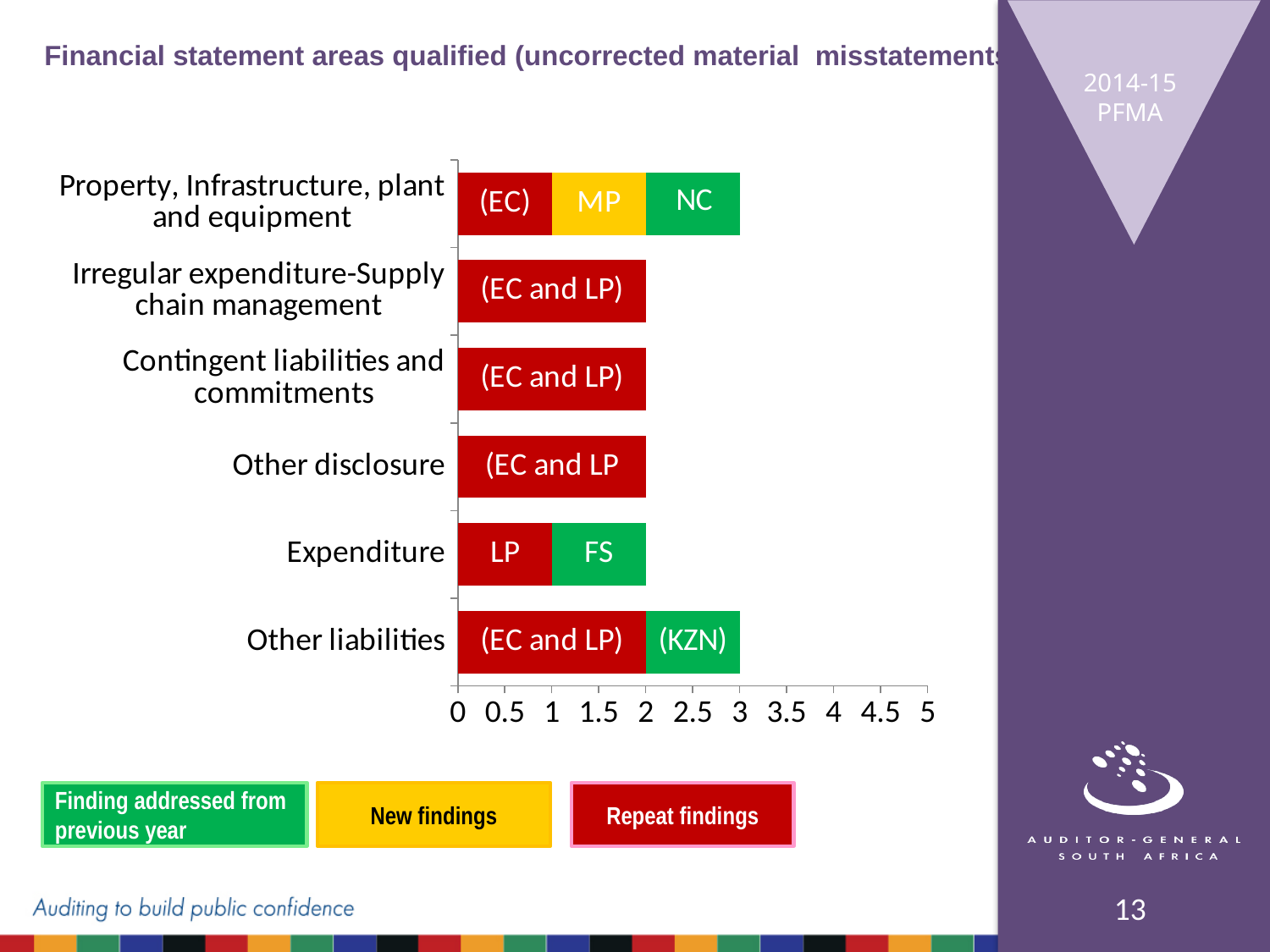
How many finding types does the legend list? 3 Which colour represents Repeat findings in the legend? Red What is the total length of the stacked bar for Other liabilities? 3 What is the total length of the stacked bar for Expenditure? 2 What is the total length of the stacked bar for Property, Infrastructure, plant and equipment? 3 What is the difference between the total bar length for Property, Infrastructure, plant and equipment and the total for Expenditure? 1 What label appears on the green segment of the Expenditure bar? FS Is the value for Irregular expenditure-Supply chain management greater or less than 2.5? less Which bar is longer: Property, Infrastructure, plant and equipment or Other disclosure? Property, Infrastructure, plant and equipment Is the value for Contingent liabilities and commitments greater or less than 1? greater What kind of chart is shown on the slide? Bar chart How many financial statement areas (categories) are listed on the chart? 6